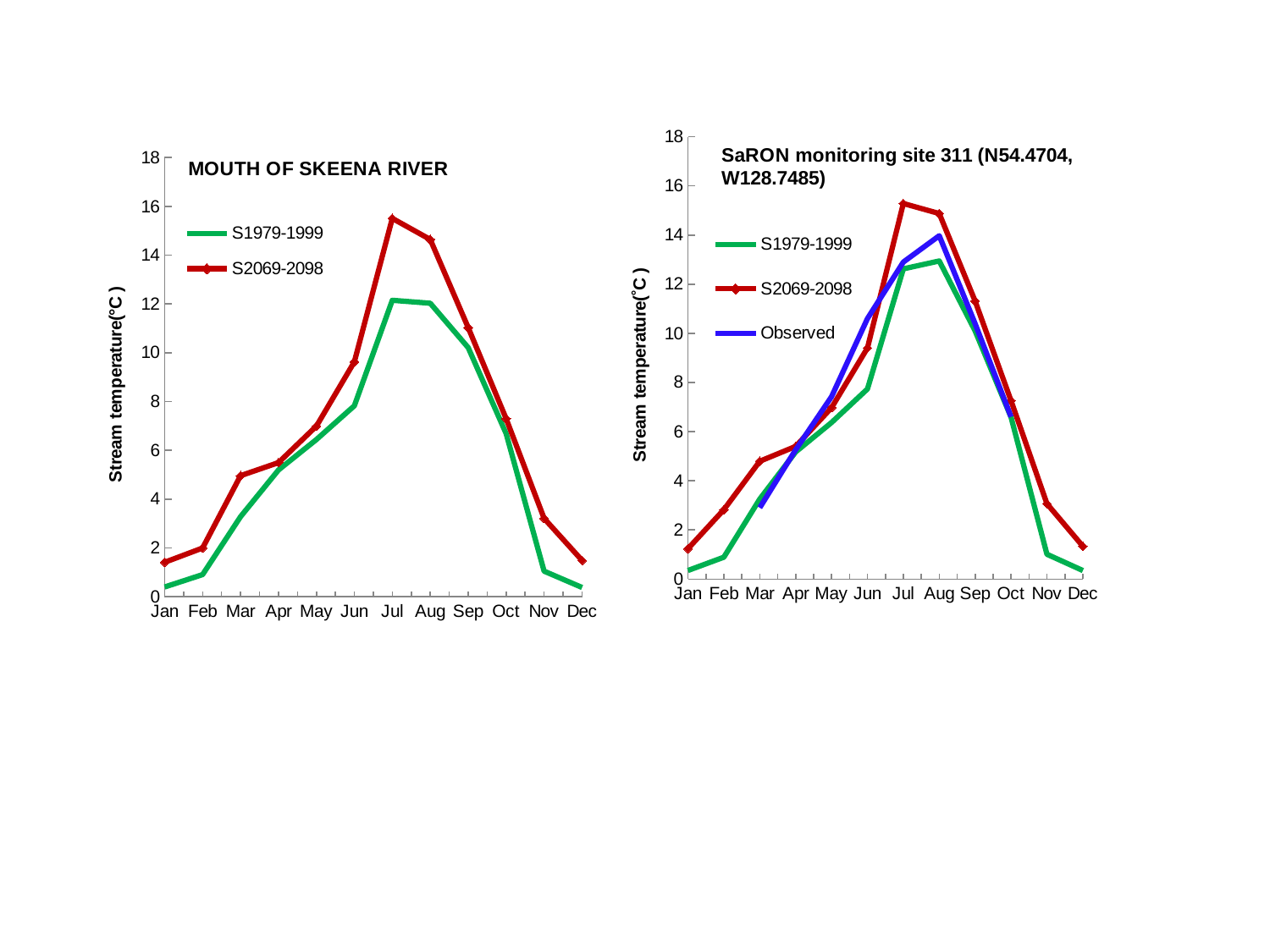
How many series does the legend of the MOUTH OF SKEENA RIVER chart list? 2 How many series does the legend of the SaRON monitoring site 311 chart list? 3 In the MOUTH OF SKEENA RIVER chart, is the S2069-2098 value for Jul greater or less than 14? greater In the MOUTH OF SKEENA RIVER chart, in which month does the S2069-2098 series reach its highest value? Jul In the SaRON monitoring site 311 chart, in which month does the Observed series reach its highest value? Aug In the SaRON monitoring site 311 chart, which series has the larger value in Jul, S1979-1999 or S2069-2098? S2069-2098 In the MOUTH OF SKEENA RIVER chart, is the S1979-1999 value for Nov greater or less than 2? less What kind of chart is the MOUTH OF SKEENA RIVER chart? Line chart What is the y-axis label of the SaRON monitoring site 311 chart? Stream temperature(°C) How many months are plotted along the x axis of the MOUTH OF SKEENA RIVER chart? 12 In the MOUTH OF SKEENA RIVER chart, does the S1979-1999 series rise or fall from Jan to Jul? Rise In the SaRON monitoring site 311 chart, in which month does the S2069-2098 series reach its highest value? Jul